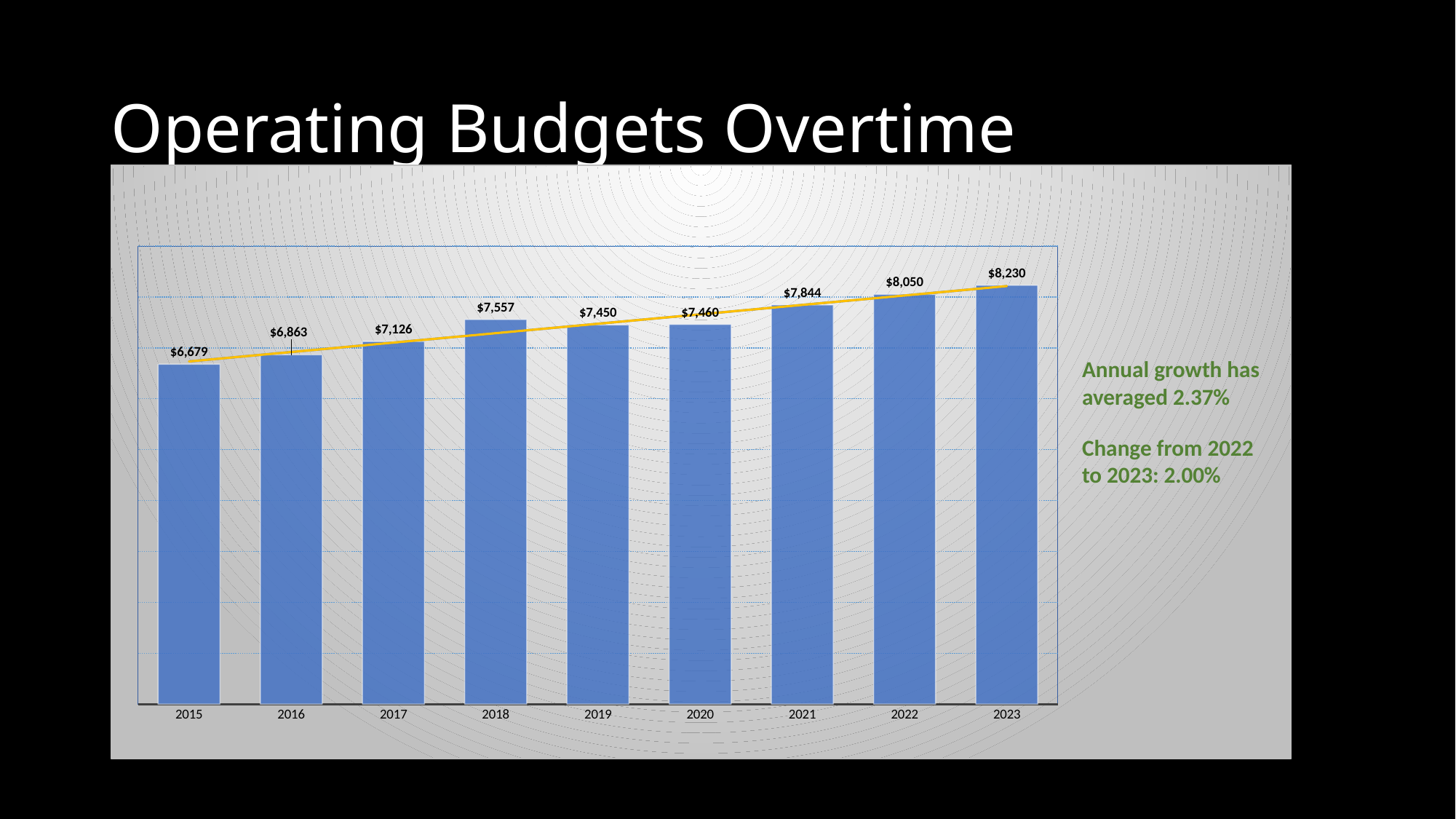
What is the operating budget value shown for 2015? $6,679 What is the operating budget value shown for 2020? $7,460 Which year has the lowest operating budget? 2015 Which year has the highest operating budget? 2023 What is the operating budget value shown for 2023? $8,230 Which is larger, the operating budget for 2018 or for 2019? 2018 Do the operating budget values generally rise or fall from 2015 to 2023? Rise How many years are shown on the x axis of the chart? 9 What is the title of the slide containing the chart? Operating Budgets Overtime What kind of chart is shown on the slide? Bar chart What is the difference between the 2018 and 2019 operating budgets? $107 What is the difference between the 2023 and 2022 operating budgets? $180